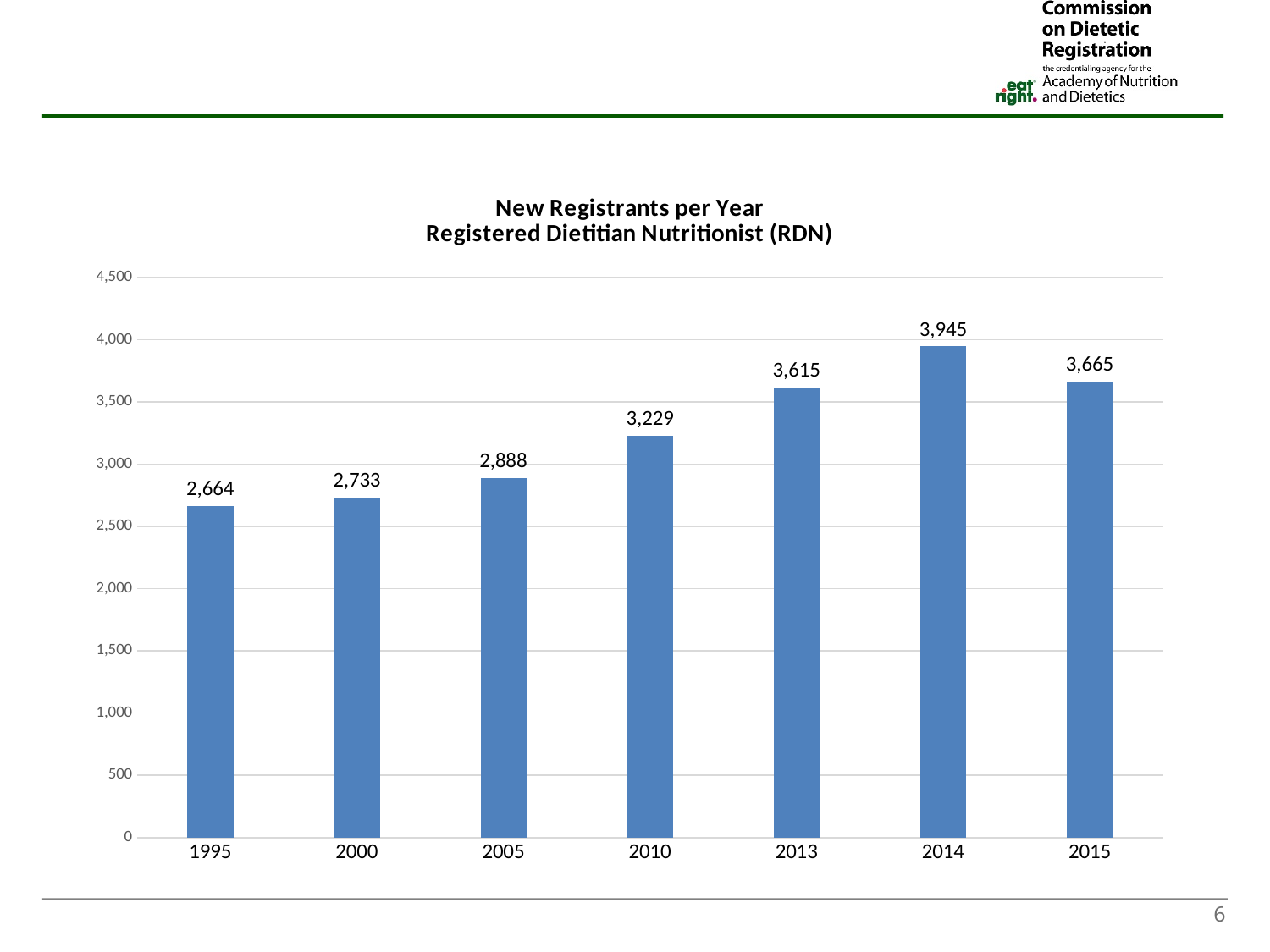
How many years are shown on the chart? 7 What is the number of new RDN registrants in 2015? 3,665 Which year has the lowest number of new registrants? 1995 What is the number of new RDN registrants in 1995? 2,664 Is the value for 2013 greater or less than 3,500? greater Which year had more new registrants, 2013 or 2015? 2015 What is the difference between the number of new registrants in 2014 and in 2015? 280 What kind of chart is shown on the slide? Bar chart What is the difference between the number of new registrants in 2005 and in 2000? 155 What is the title of the chart? New Registrants per Year Registered Dietitian Nutritionist (RDN) What is the number of new RDN registrants in 2010? 3,229 Which year has the highest number of new registrants? 2014